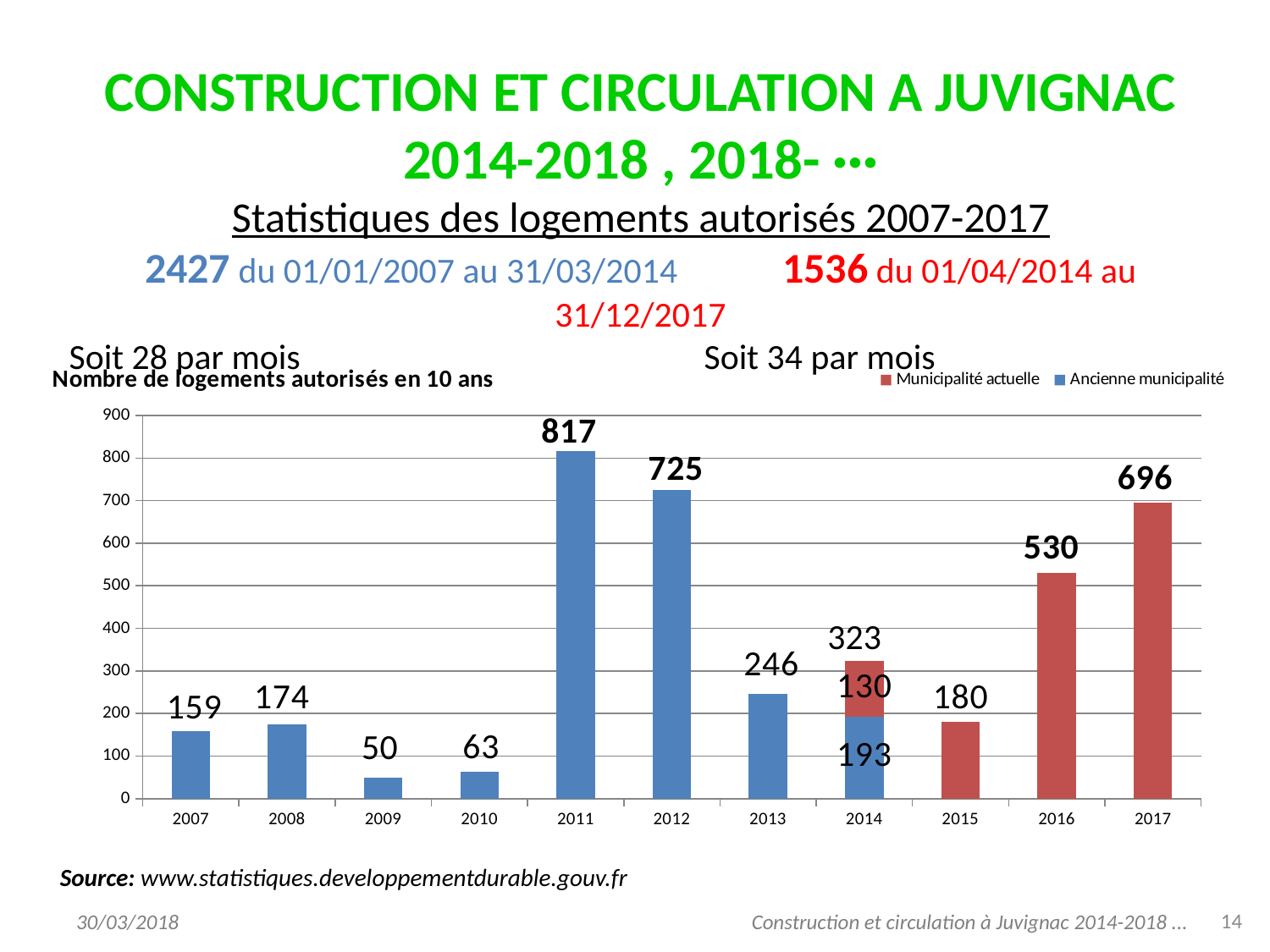
How many years are shown on the x axis of the chart? 11 What is the value of the Municipalité actuelle series for 2014? 130 Which is larger, the value for 2016 or the value for 2017? 2017 What type of chart is shown on the slide? Bar chart How many series does the chart legend list? 2 What is the value of the Ancienne municipalité series for 2014? 193 Which year has the highest value in the chart? 2011 Which year has the lowest value in the chart? 2009 What is the total of the stacked bar for 2014? 323 What is the value for 2011 in the chart? 817 What is the value for 2009 in the chart? 50 What is the difference between the values for 2011 and 2012? 92